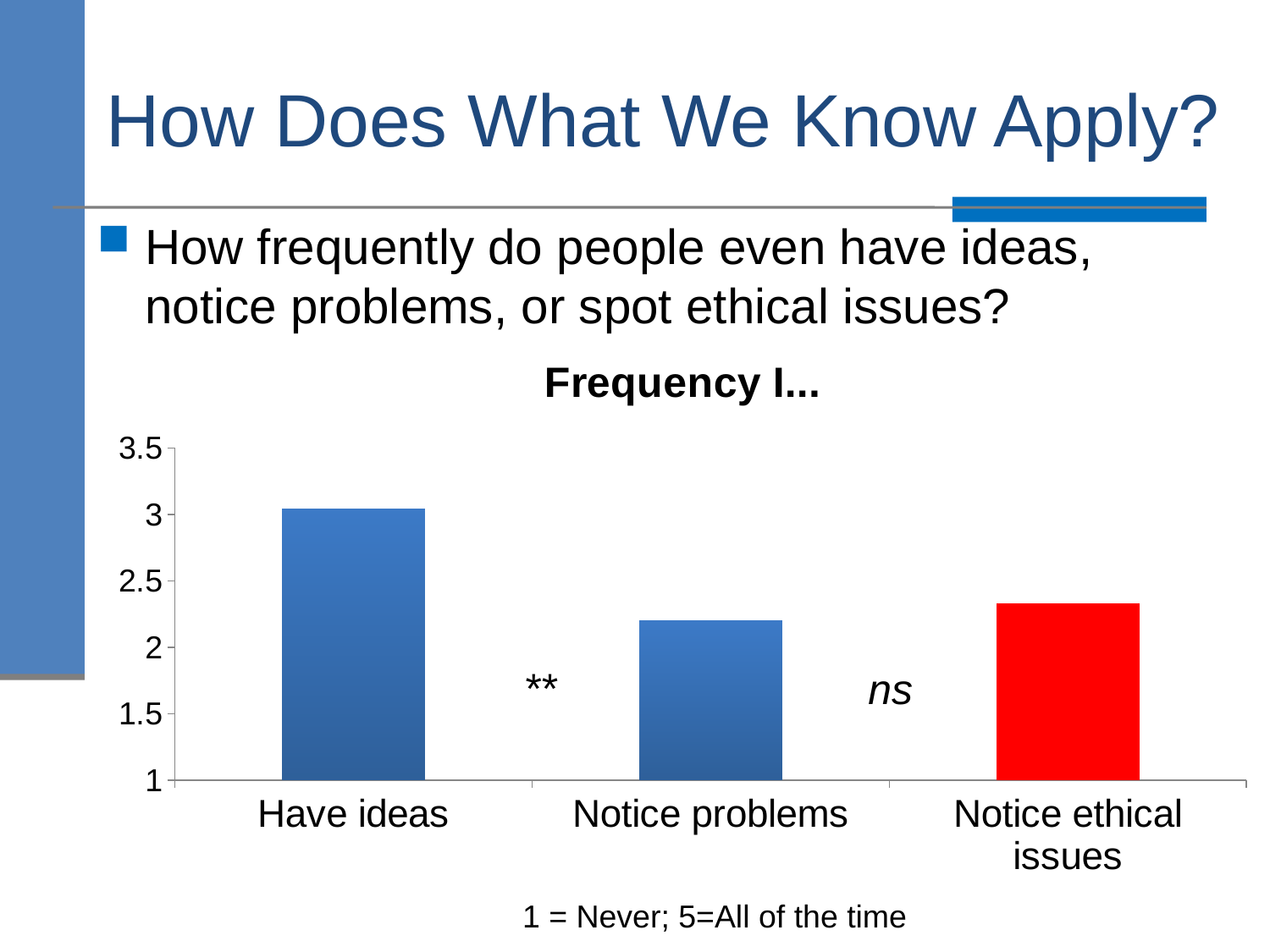
Is the value for Notice problems greater or less than 2.5? less What kind of chart is shown on the slide? bar chart How many categories are shown on the x axis of the chart? 3 What colour is the bar for Notice ethical issues? red Which is larger, the value for Have ideas or the value for Notice problems? Have ideas Is the value for Notice ethical issues greater or less than 2? greater Which is larger, the value for Notice ethical issues or the value for Notice problems? Notice ethical issues Which category has the highest bar in the chart? Have ideas Which category has the lowest bar in the chart? Notice problems Is the value for Have ideas greater or less than 2.5? greater What is the title of the chart? Frequency I...